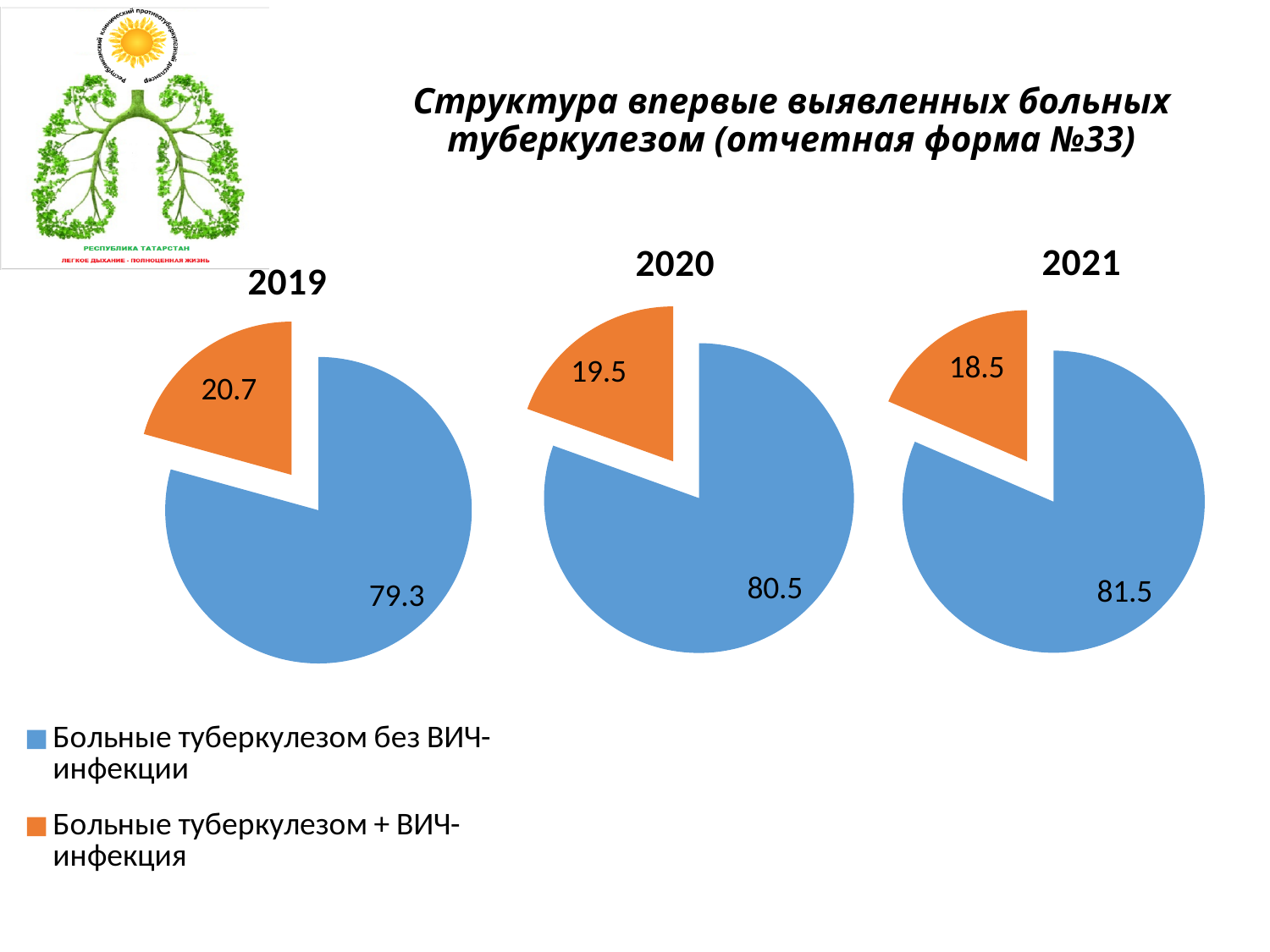
Is the value for patients with tuberculosis + HIV infection larger in the 2019 chart or the 2021 chart? 2019 In the 2021 pie chart, what is the value for patients with tuberculosis + HIV infection? 18.5 In the 2021 pie chart, what is the value for patients with tuberculosis without HIV infection? 81.5 In the 2019 pie chart, what is the value for patients with tuberculosis + HIV infection (Больные туберкулезом + ВИЧ-инфекция)? 20.7 In the 2020 pie chart, what is the difference between the two slice values? 61 In the 2019 pie chart, what is the value for patients with tuberculosis without HIV infection (Больные туберкулезом без ВИЧ-инфекции)? 79.3 How many series does the legend list? 2 In the 2019 pie chart, which category has the smallest slice? Больные туберкулезом + ВИЧ-инфекция What kind of chart is used for the 2019, 2020 and 2021 data? Pie chart In the 2020 pie chart, what is the value for patients with tuberculosis + HIV infection? 19.5 In the 2020 pie chart, which category has the largest slice? Больные туберкулезом без ВИЧ-инфекции Across the 2019, 2020 and 2021 pie charts, does the share of patients with tuberculosis + HIV infection rise or fall over the years? Fall